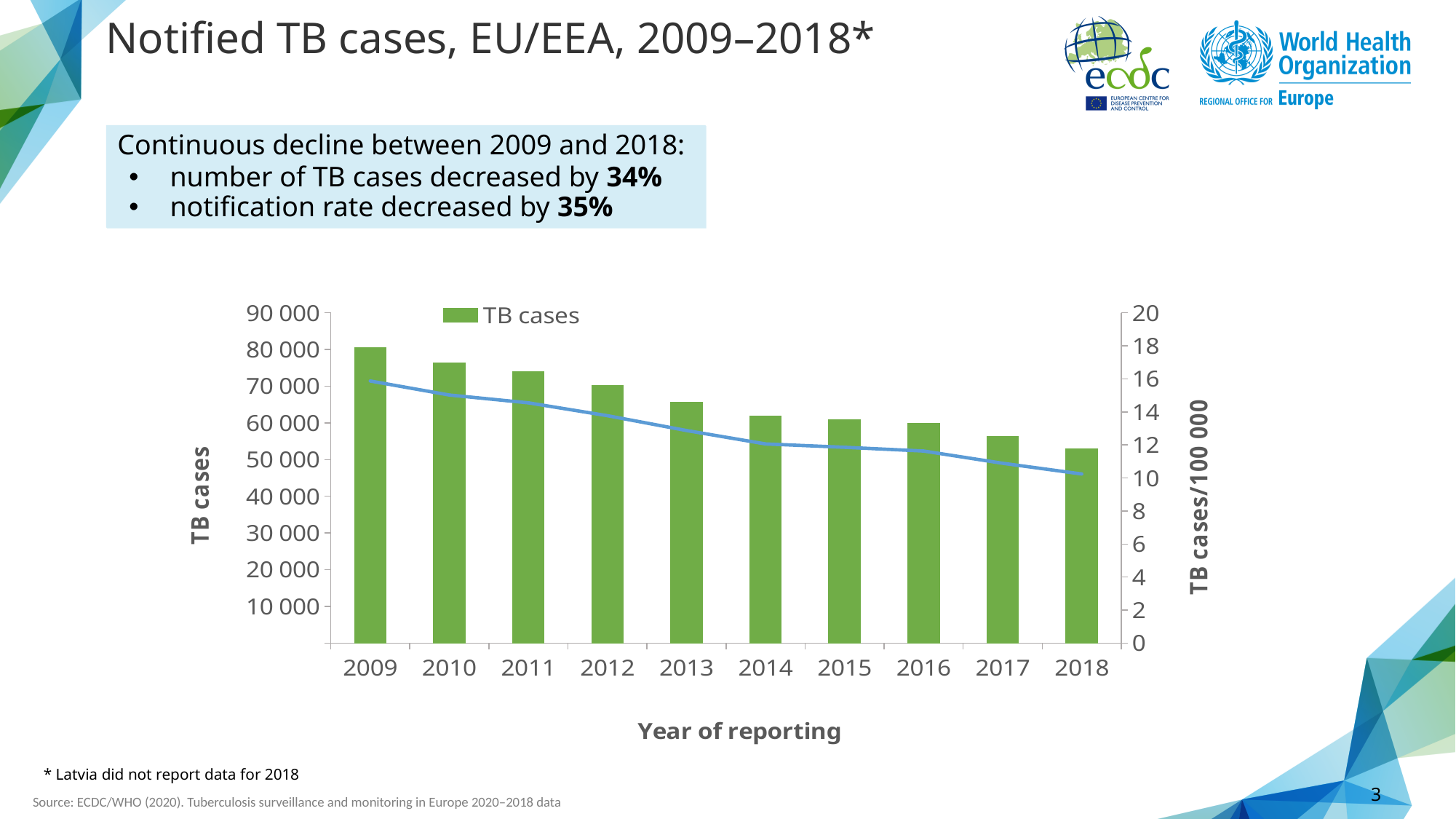
Which year has the lowest number of TB cases in the chart? 2018 What is the title of the right-hand y axis of the chart? TB cases/100 000 Is the number of TB cases for 2014 greater or less than 70 000? less Do the TB cases rise or fall from 2009 to 2018 in the chart? Fall Is the number of TB cases for 2009 greater or less than 70 000? greater Which year has more TB cases, 2013 or 2016? 2013 What kind of chart is shown on the slide? A bar chart with a line overlaid Is the number of TB cases for 2018 greater or less than 60 000? less How many years are plotted along the x axis of the chart? 10 What is the title of the x axis of the chart? Year of reporting How many series does the chart's legend list? 1 Which year has the highest number of TB cases in the chart? 2009